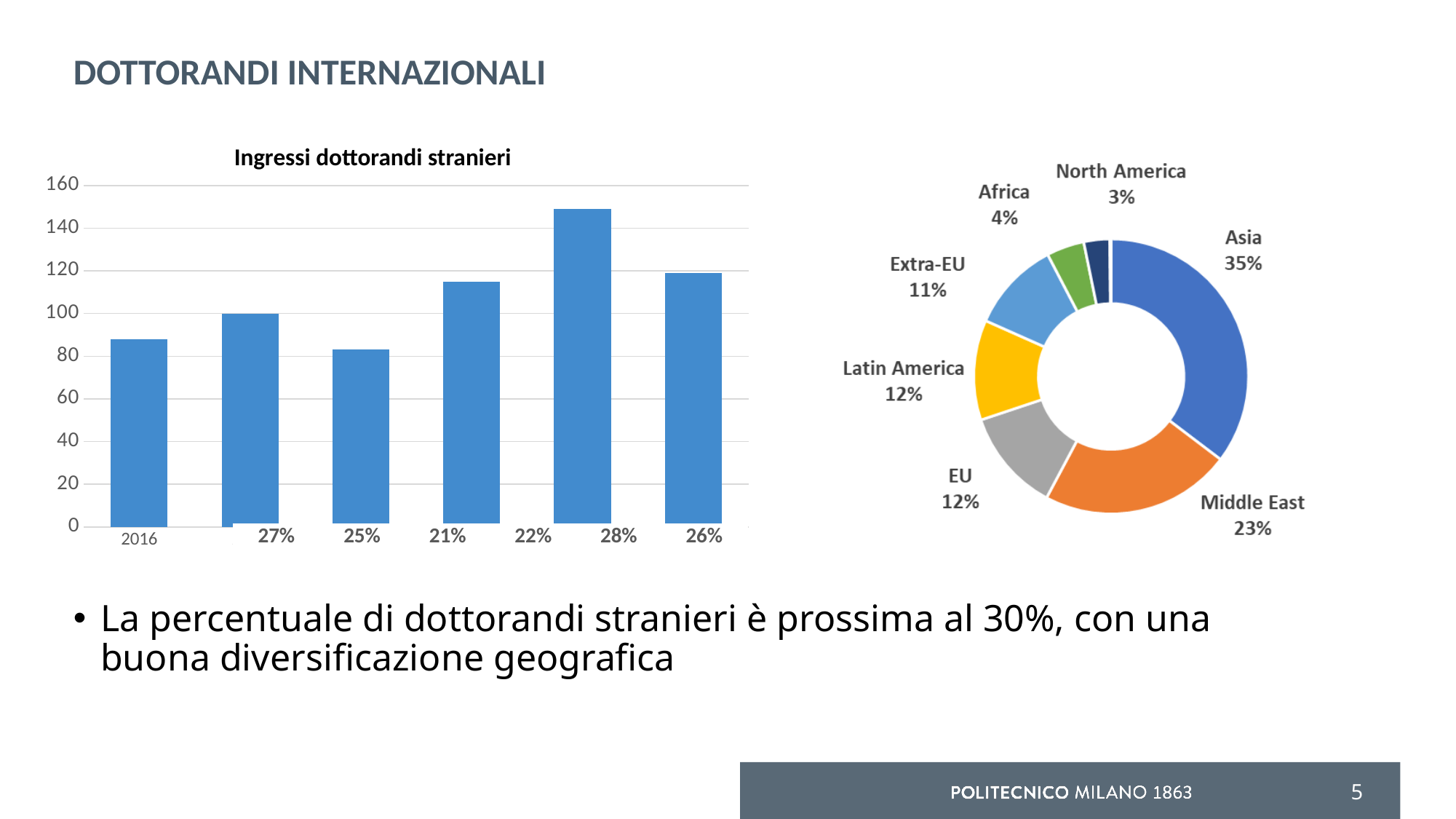
In the doughnut chart on the right, which region has the largest share? Asia What kind of chart is the chart on the right showing regions such as Asia and Middle East? Doughnut (pie) chart In the doughnut chart on the right, what is the difference between the shares of Asia and Middle East? 12 percentage points In the doughnut chart on the right, what share does Asia have? 35% In the doughnut chart on the right, what share does Middle East have? 23% How many bars are shown in the bar chart 'Ingressi dottorandi stranieri'? 6 In the doughnut chart on the right, which region has the smallest share? North America What kind of chart is the chart on the left titled 'Ingressi dottorandi stranieri'? Bar chart How many regions are shown in the doughnut chart on the right? 7 In the bar chart 'Ingressi dottorandi stranieri', is the value of the third bar greater or less than 100? less In the doughnut chart on the right, which has the larger share, Extra-EU or Africa? Extra-EU In the bar chart 'Ingressi dottorandi stranieri', is the value of the fifth bar greater or less than 140? greater